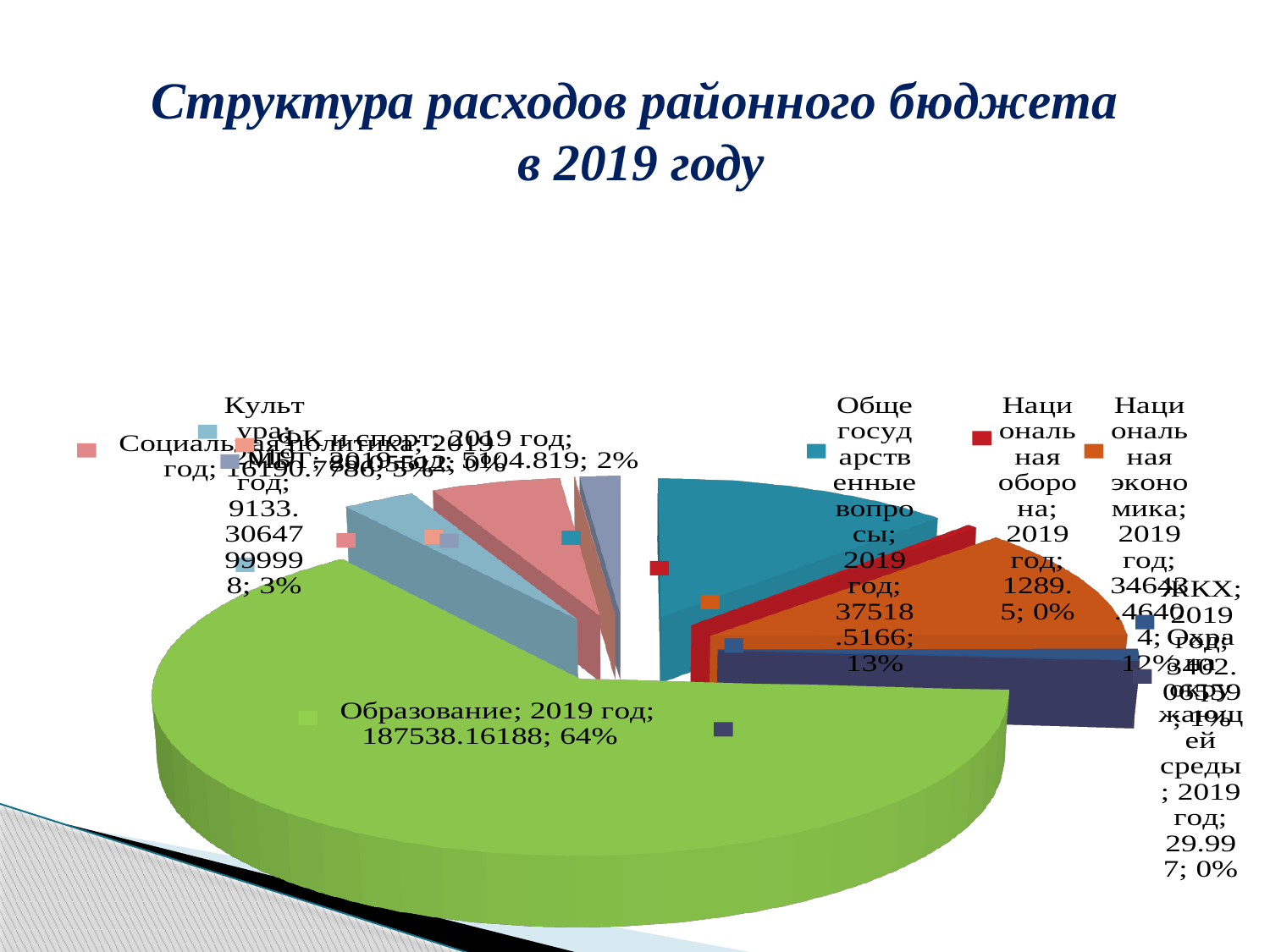
Which category has the largest slice of the pie? Образование What kind of chart is shown on the slide? pie chart What is the value shown for Охрана окружающей среды? 29.997 What is the value shown for Общегосударственные вопросы? 37518.5166 What share of the pie does Образование account for? 64% What is the value shown for Национальная оборона? 1289.5 What is the value shown for Образование? 187538.16188 What is the title of the chart on the slide? Структура расходов районного бюджета в 2019 году What share of the pie does Общегосударственные вопросы account for? 13% Which is larger, the value for Образование or the value for Общегосударственные вопросы? Образование What share of the pie does ФК и спорт account for? 0% What is the difference between the values for Образование and Общегосударственные вопросы? 150019.64528